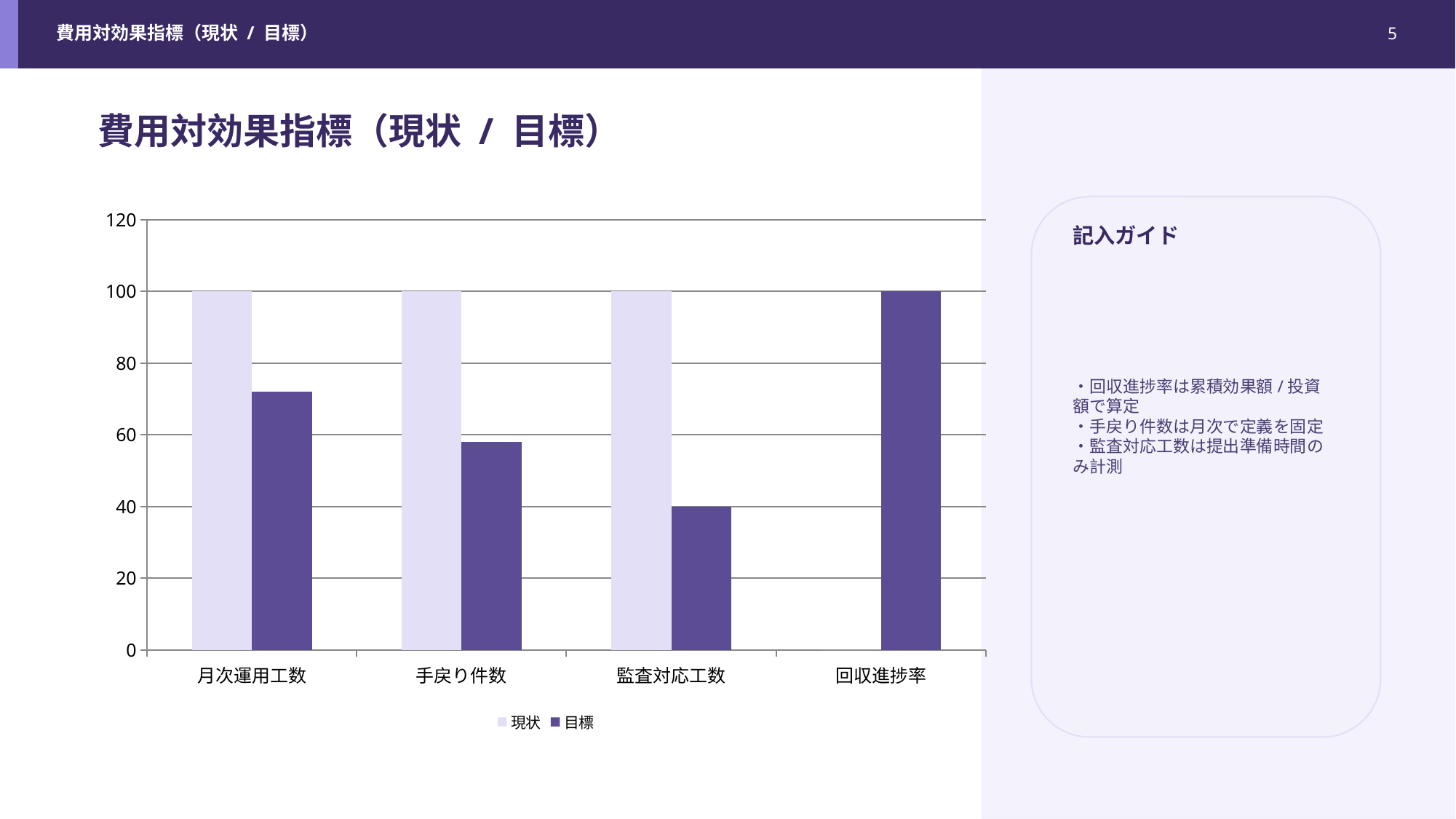
Is the 目標 value for 月次運用工数 greater or less than 60? greater How many series does the legend list? 2 Which category has the lowest 目標 value? 監査対応工数 Is the 目標 value for 手戻り件数 greater or less than 80? less What is the 目標 value for 回収進捗率? 100 What kind of chart is shown on the slide? Bar chart Which category has the highest 目標 value? 回収進捗率 What is the difference between the 現状 and 目標 values for 監査対応工数? 60 What is the 現状 value for 月次運用工数? 100 What are the two entries in the chart legend? 現状 and 目標 What is the 目標 value for 監査対応工数? 40 How many categories are shown on the x axis? 4